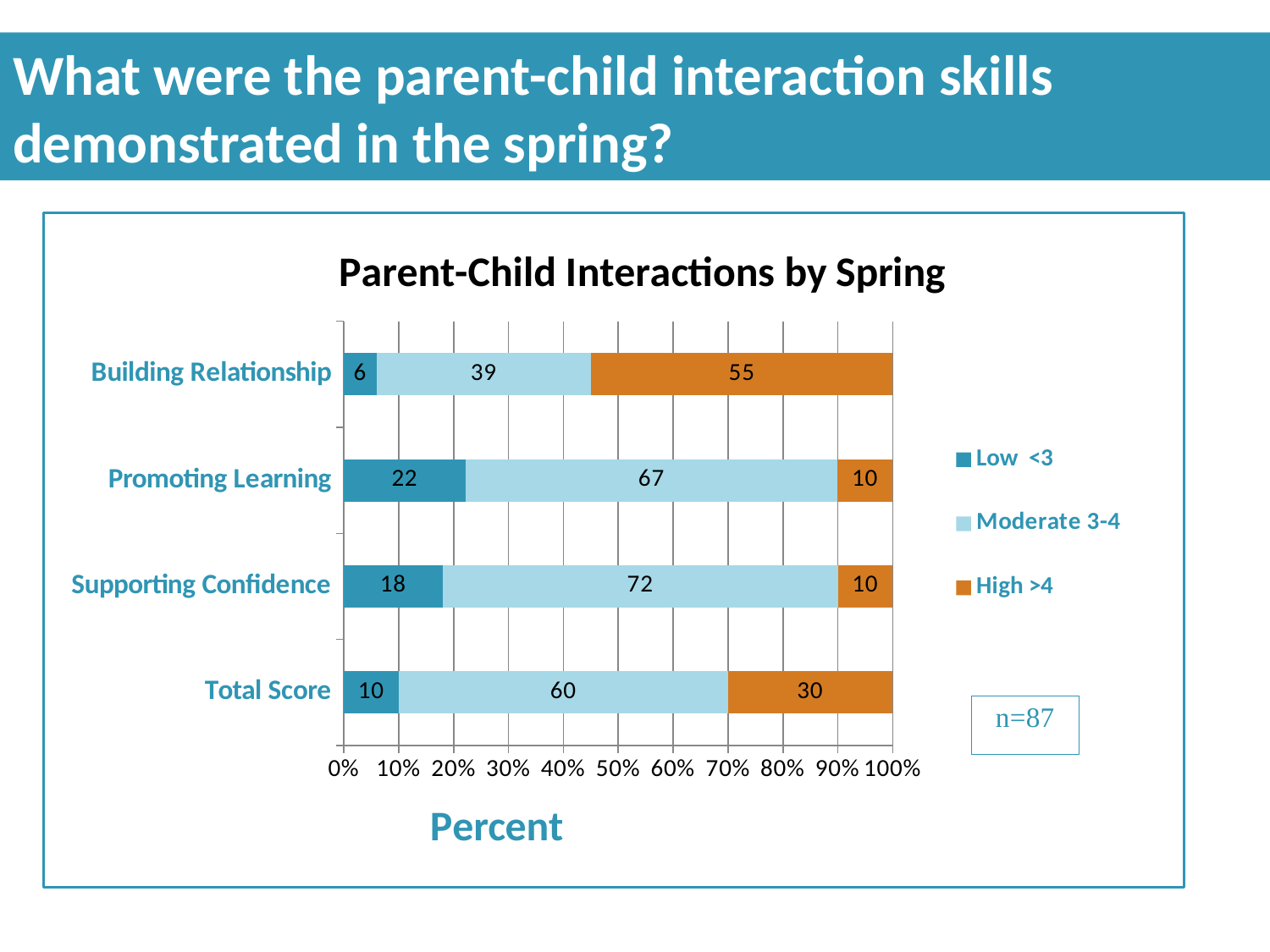
What kind of chart is shown? Stacked bar chart What is the difference between the Moderate 3-4 values for Supporting Confidence and Building Relationship? 33 How many series does the legend list? 3 What is the title of the chart? Parent-Child Interactions by Spring Which is larger: the High >4 value for Total Score or the High >4 value for Promoting Learning? Total Score Which category has the lowest Low <3 value? Building Relationship Which category has the highest High >4 value? Building Relationship What is the total of the stacked bar for Total Score? 100 What is the value for Moderate 3-4 in the Supporting Confidence category? 72 What is the value for High >4 in the Building Relationship category? 55 What is the value for Low <3 in the Promoting Learning category? 22 How many categories are shown on the y axis? 4